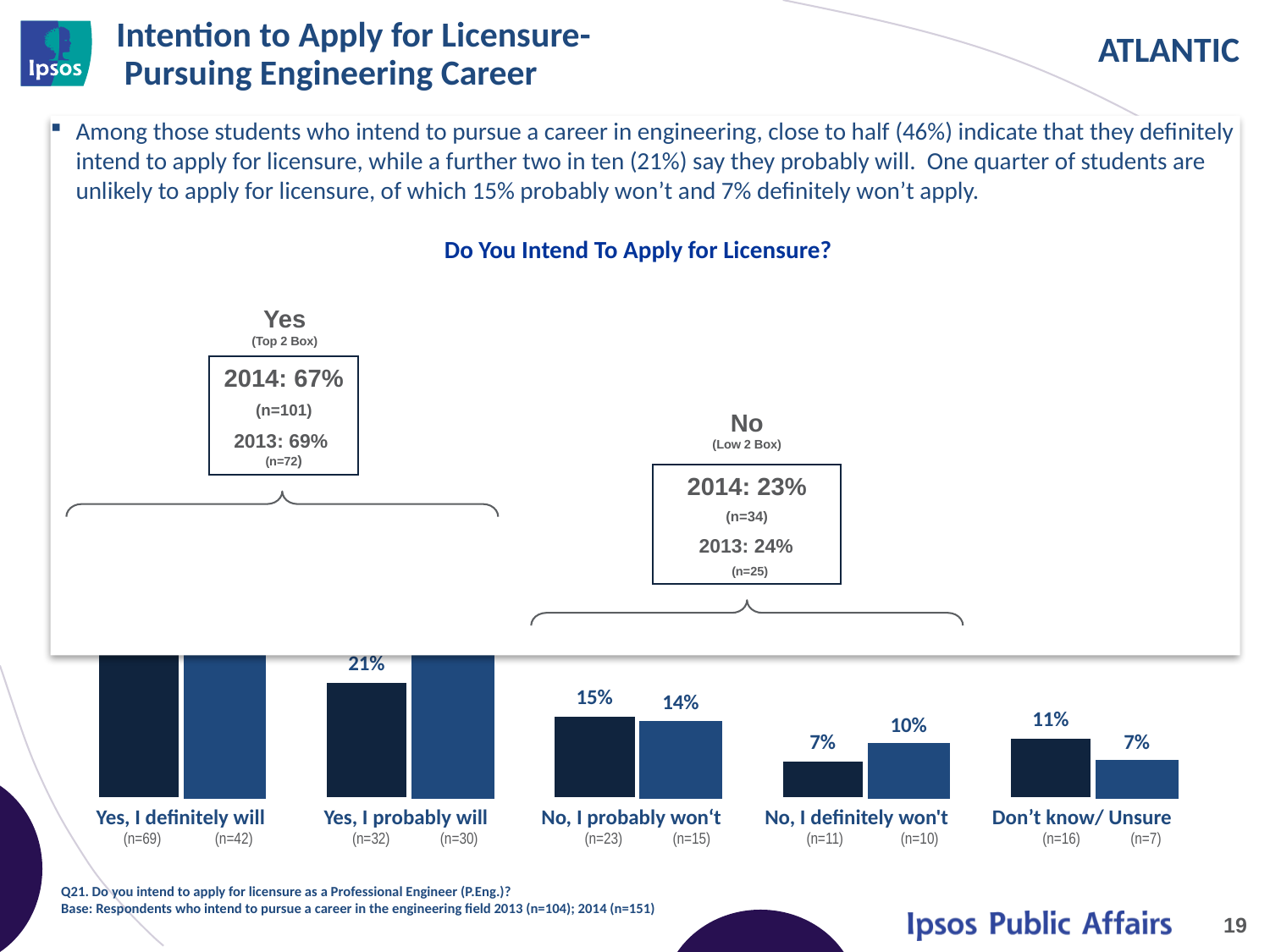
What is the difference between the darker and lighter bars for "Don't know/ Unsure"? 4 percentage points What is the value of the darker (first) bar for "No, I probably won't"? 15% What kind of chart is shown on the slide? bar chart What is the value of the darker (first) bar for "Yes, I probably will"? 21% What is the value of the darker (first) bar for "Don't know/ Unsure"? 11% What is the value of the darker (first) bar for "No, I definitely won't"? 7% For "No, I definitely won't", which bar is larger, the darker (first) bar or the lighter (second) bar? the lighter (second) bar How many response categories are shown along the x axis of the chart? 5 What is the title of the chart? Do You Intend To Apply for Licensure? Which response category has the tallest bars in the chart? Yes, I definitely will What is the value of the lighter (second) bar for "No, I definitely won't"? 10% What is the value of the lighter (second) bar for "No, I probably won't"? 14%